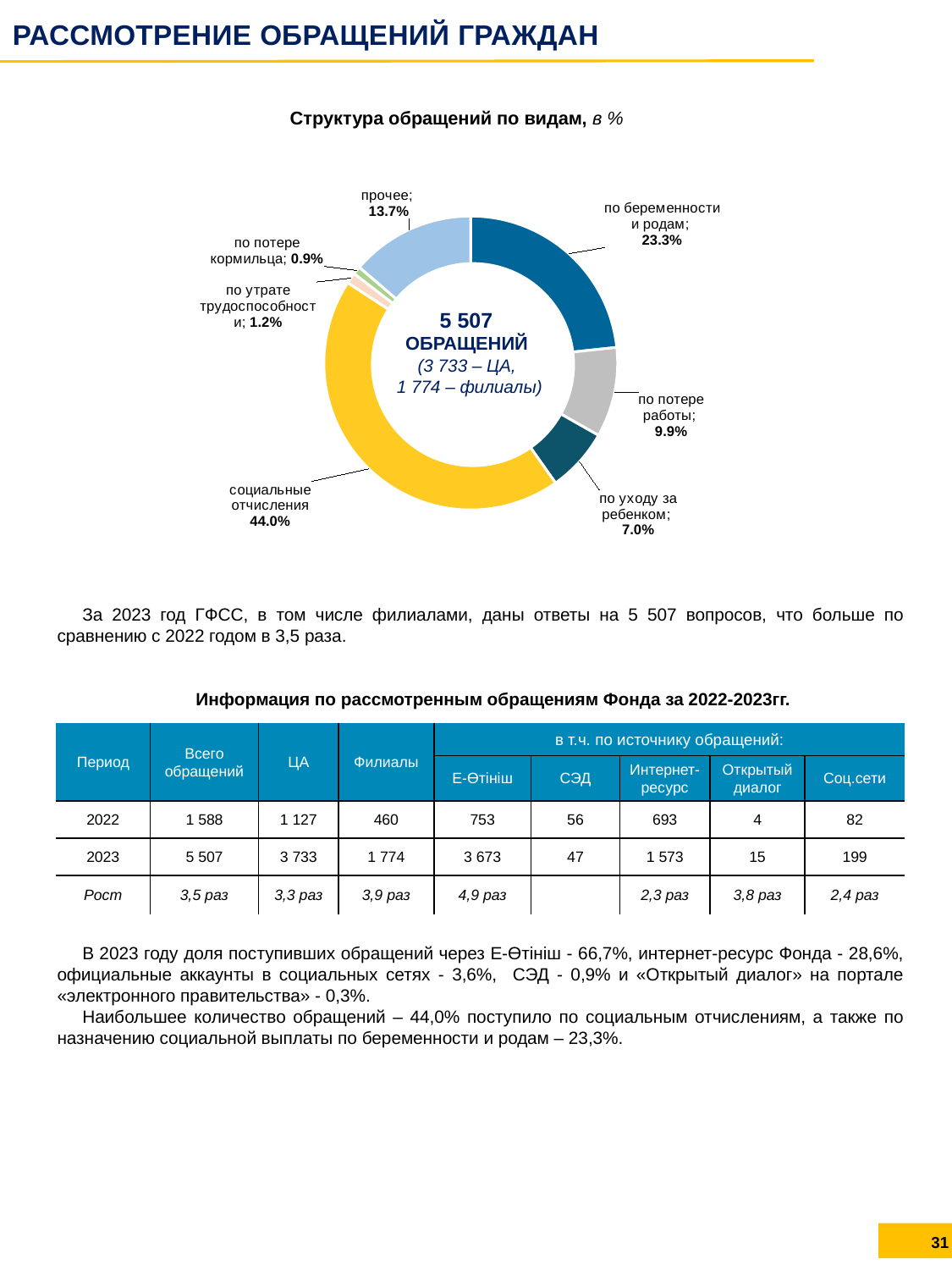
What share of appeals is for «прочее»? 13.7% What share of appeals is for «по уходу за ребенком»? 7.0% Which is larger: the share for «прочее» or the share for «по потере работы»? прочее Which category has the smallest share of appeals in the chart? по потере кормильца What share of appeals is for «по потере работы»? 9.9% What is the difference in percentage points between «социальные отчисления» and «по беременности и родам»? 20.7 Which category has the largest share of appeals in the chart? социальные отчисления What share of appeals is for «по беременности и родам»? 23.3% How many categories (slices) does the donut chart show? 7 What total number of appeals is shown in the centre of the donut chart? 5 507 What share of appeals is for «социальные отчисления»? 44.0% What type of chart is used to show the structure of appeals by type (Структура обращений по видам)? Pie (donut) chart